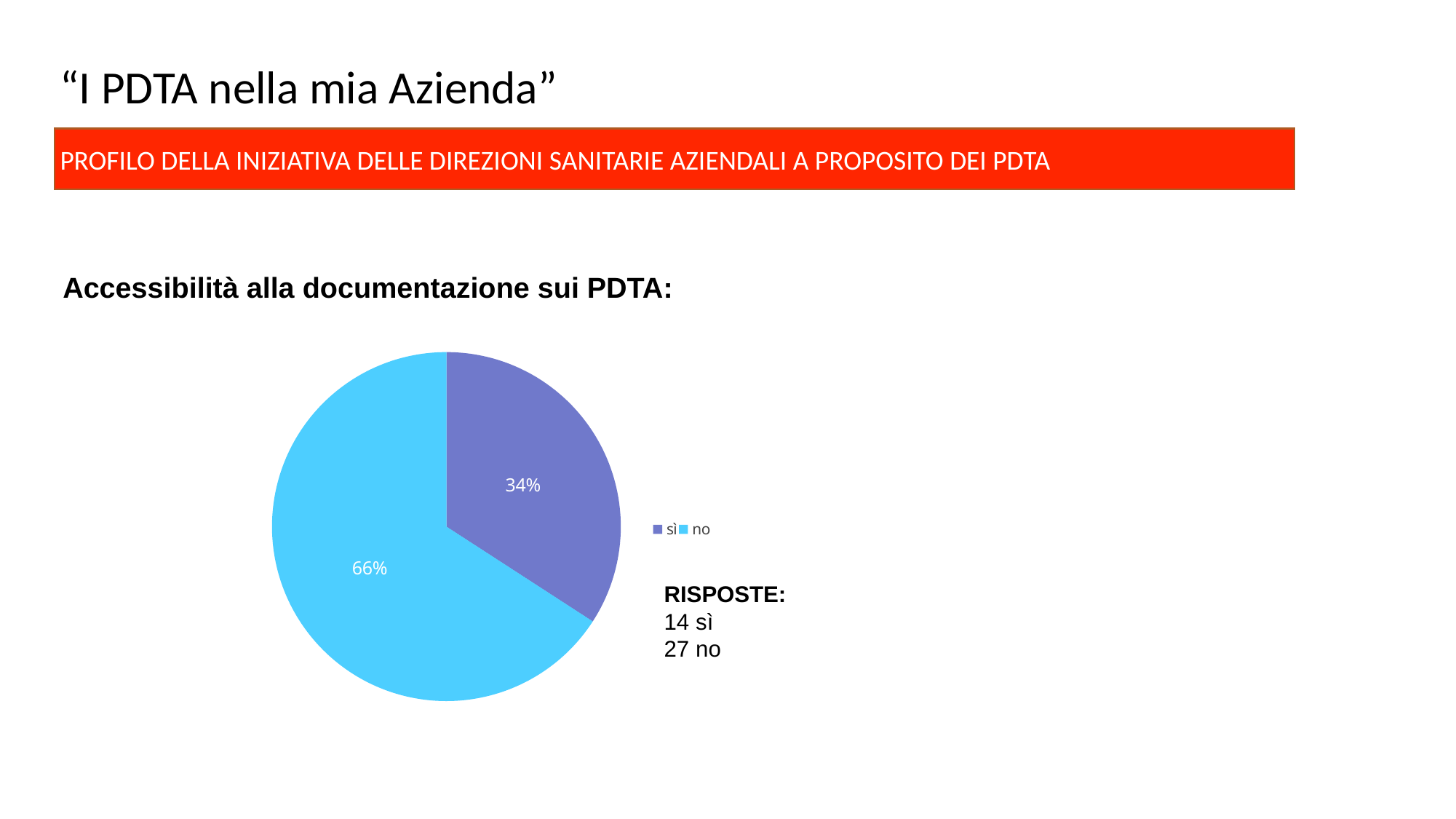
Which slice of the pie is the smallest? sì What is the difference in percentage points between the "no" slice and the "sì" slice? 32 What percentage of the pie is labelled "no"? 66% Which slice of the pie is the largest? no How many slices does the pie chart have? 2 What colour is the "no" slice of the pie? light blue Which slice is larger, "sì" or "no"? no What is the heading printed above the pie chart? Accessibilità alla documentazione sui PDTA: How many entries does the legend list? 2 What percentage of the pie is labelled "sì"? 34% According to the text next to the chart, how many "sì" responses were there? 14 What kind of chart is shown on the slide? pie chart